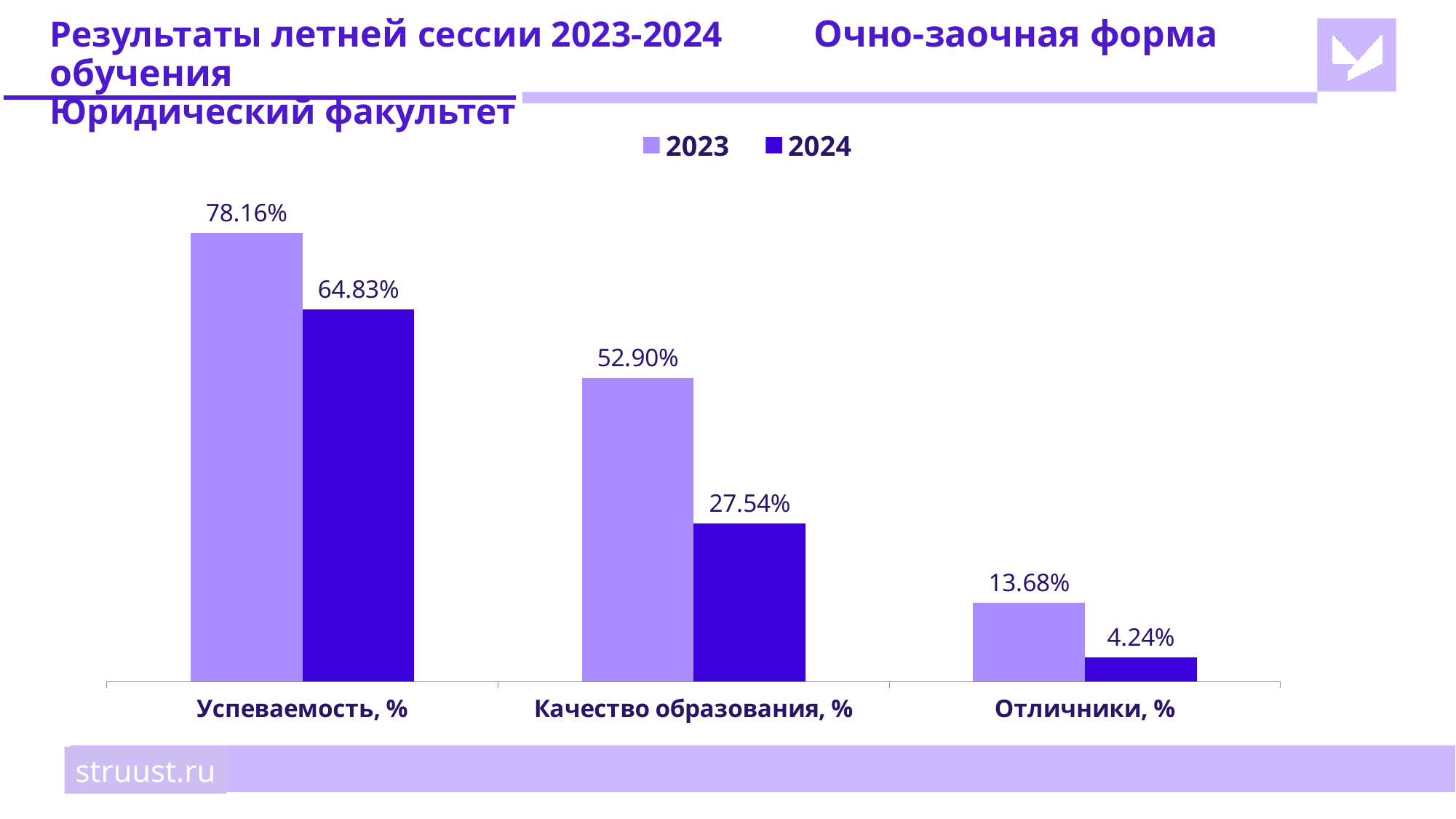
Which category has the highest 2024 value? Успеваемость, % What is the 2024 value for Отличники, %? 4.24% What is the 2023 value for Отличники, %? 13.68% How many series does the legend list? 2 What is the difference between the 2023 and 2024 values for Качество образования, %? 25.36% What is the 2024 value for Качество образования, %? 27.54% What is the 2023 value for Успеваемость, %? 78.16% Which category has the lowest 2023 value? Отличники, % Which is larger for Отличники, %: the 2023 value or the 2024 value? 2023 What kind of chart is shown on the slide? Bar chart How many categories are shown on the x axis? 3 What is the difference between the 2023 and 2024 values for Успеваемость, %? 13.33%